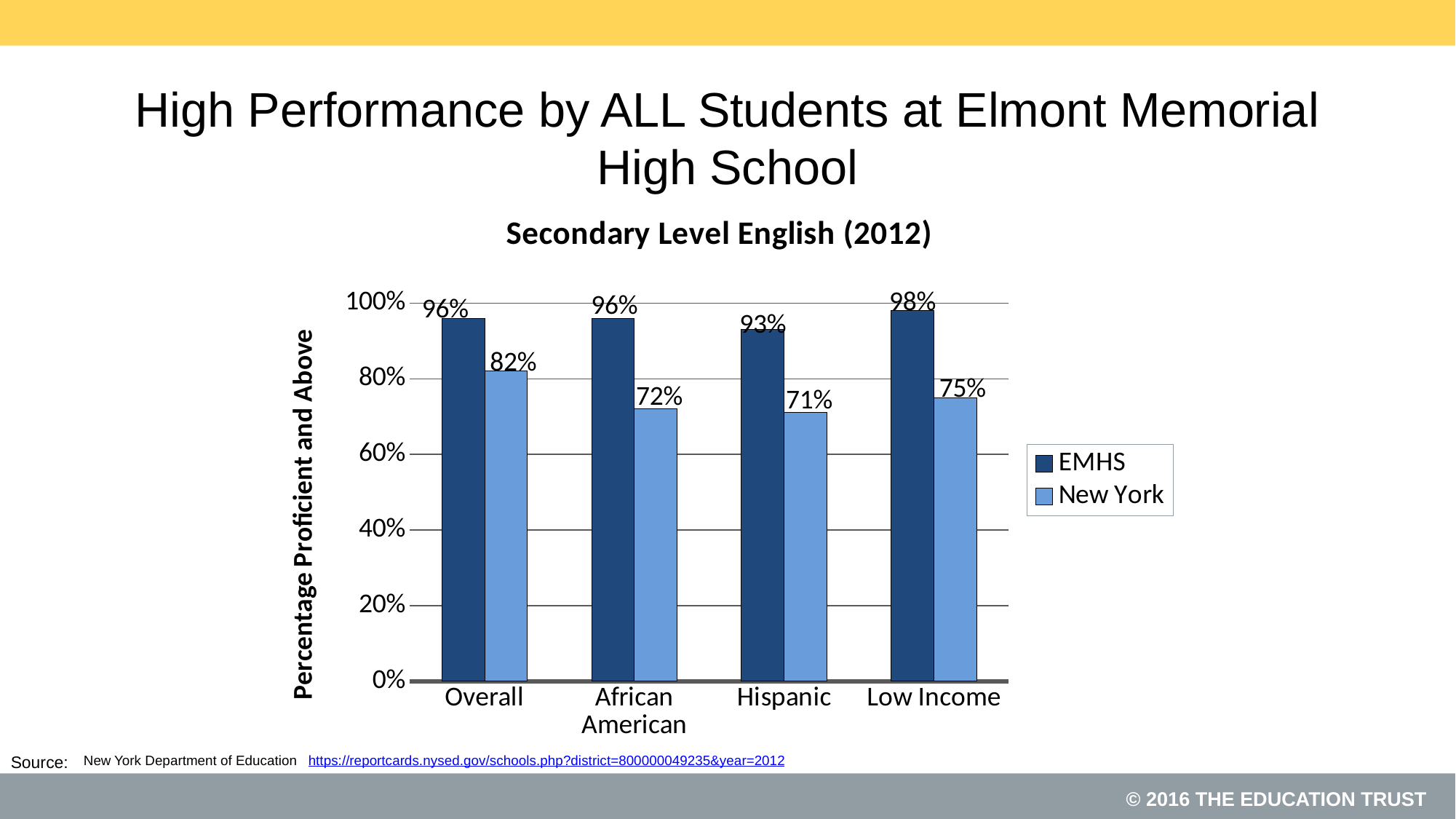
What is the EMHS value for Low Income? 98% What is the difference between the EMHS and New York values for Overall? 14% What is the EMHS value for Overall? 96% How many categories are shown on the x axis? 4 What is the New York value for African American? 72% How many series does the legend list? 2 What is the New York value for Hispanic? 71% Which category has the highest EMHS value? Low Income What kind of chart is shown on the slide? Bar chart What is the difference between the EMHS and New York values for African American? 24% Which category has the lowest New York value? Hispanic Which is larger for Low Income, the EMHS value or the New York value? EMHS